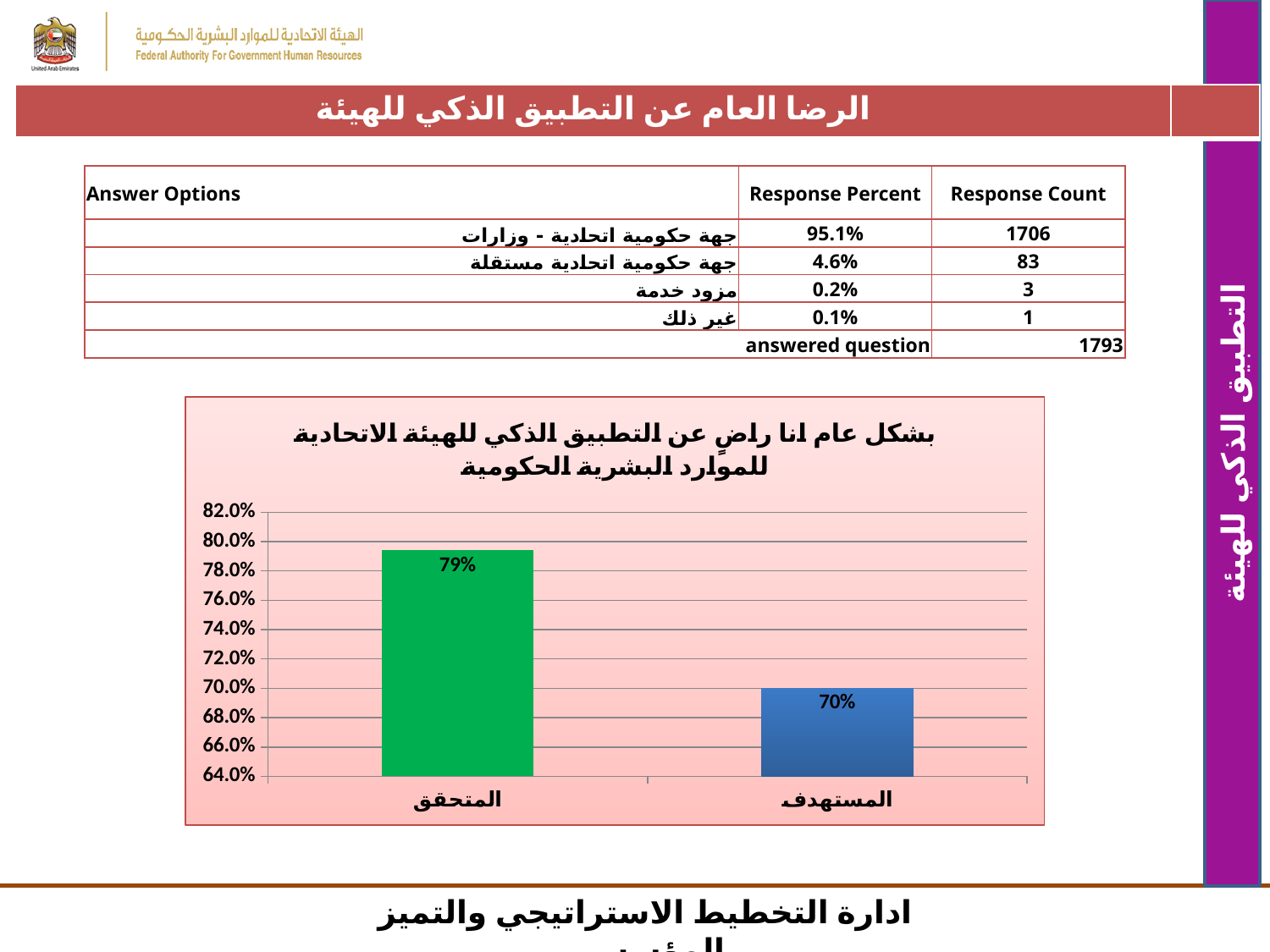
Which is larger, the value for المتحقق or the value for المستهدف? المتحقق How many categories are shown in the chart? 2 Which category has the lowest value in the chart? المستهدف Which category has the highest value in the chart? المتحقق What kind of chart is shown on the slide? bar chart What is the lowest value shown on the chart's vertical axis? 64.0% What colour is the bar for المتحقق? green Is the value for المتحقق greater or less than 76.0%? greater What is the value for المتحقق in the chart? 79% Is the value for المستهدف greater or less than 74.0%? less What is the difference between the values for المتحقق and المستهدف? 9% What is the value for المستهدف in the chart? 70%